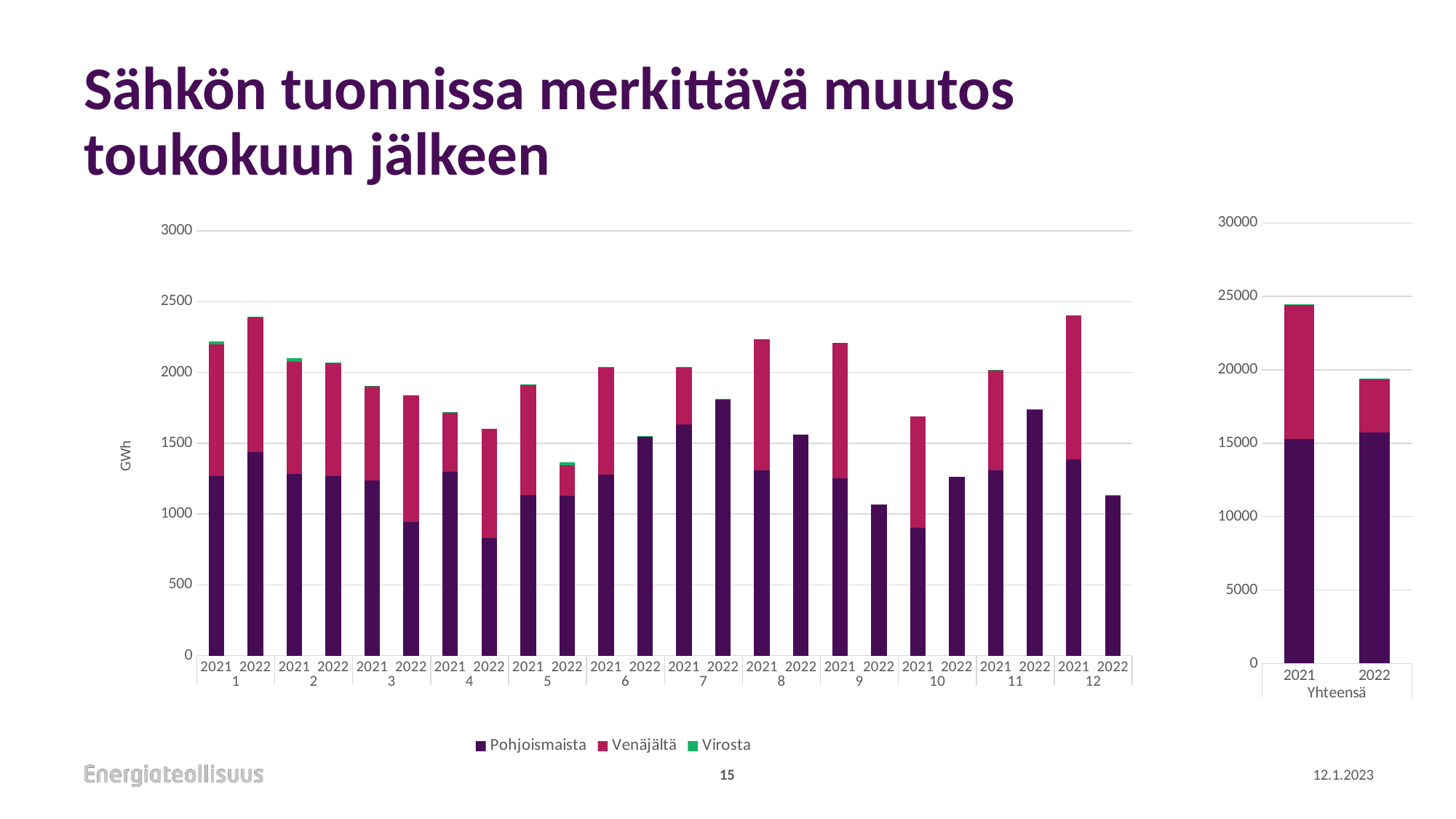
In the left chart, which bar is taller in month 12: 2021 or 2022? 2021 What kind of chart is the large chart on the left of the slide? Stacked bar chart How many bars are plotted in the left (monthly) chart? 24 In the left chart, is the total value for 2022 in month 1 greater or less than 2000? greater In the left chart, is the total value for 2021 in month 8 greater or less than 2000? greater How many bars are plotted in the right chart (Yhteensä)? 2 In the left chart, is the total value for 2022 in month 9 greater or less than 1500? less In the right chart (Yhteensä), which year has the higher total? 2021 In the left chart, which bar is taller in month 7: 2021 or 2022? 2021 What is the label on the vertical axis of the left chart? GWh How many series does the legend of the left chart list? 3